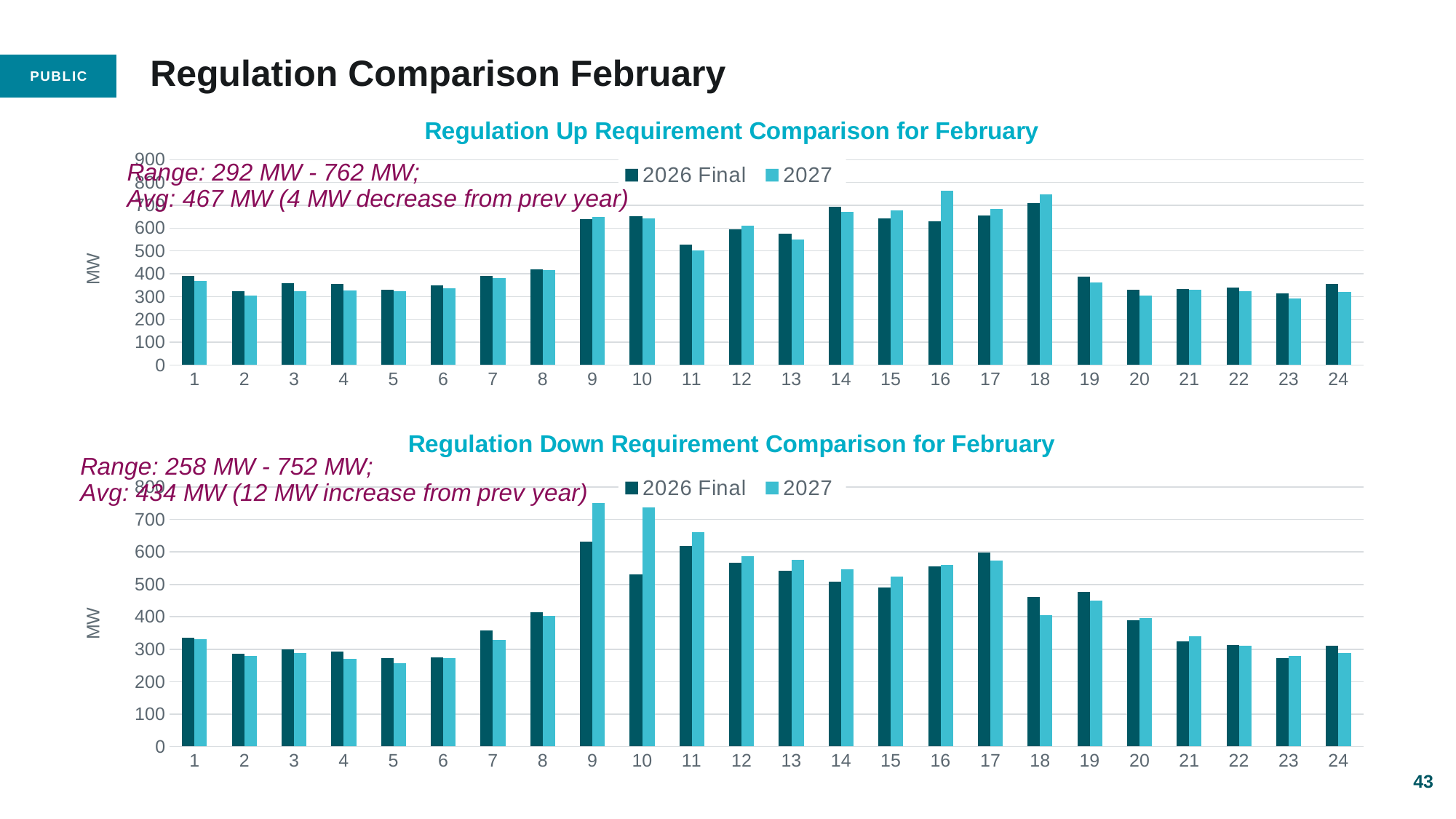
In the 'Regulation Up Requirement Comparison for February' chart, is the 2027 value for hour 2 greater or less than 400? less How many hour categories are shown on the x axis of the 'Regulation Up Requirement Comparison for February' chart? 24 In the 'Regulation Up Requirement Comparison for February' chart, which hour has the highest 2027 value? 16 What are the two legend entries in the 'Regulation Up Requirement Comparison for February' chart? 2026 Final and 2027 How many series does the legend of the 'Regulation Down Requirement Comparison for February' chart list? 2 What kind of chart is the 'Regulation Up Requirement Comparison for February' chart? bar chart In the 'Regulation Up Requirement Comparison for February' chart, is the 2027 value for hour 16 greater or less than 700? greater In the 'Regulation Down Requirement Comparison for February' chart, is the 2027 value for hour 5 greater or less than 300? less In the 'Regulation Down Requirement Comparison for February' chart, which is larger for hour 10: 2026 Final or 2027? 2027 In the 'Regulation Down Requirement Comparison for February' chart, which is larger for hour 18: 2026 Final or 2027? 2026 Final